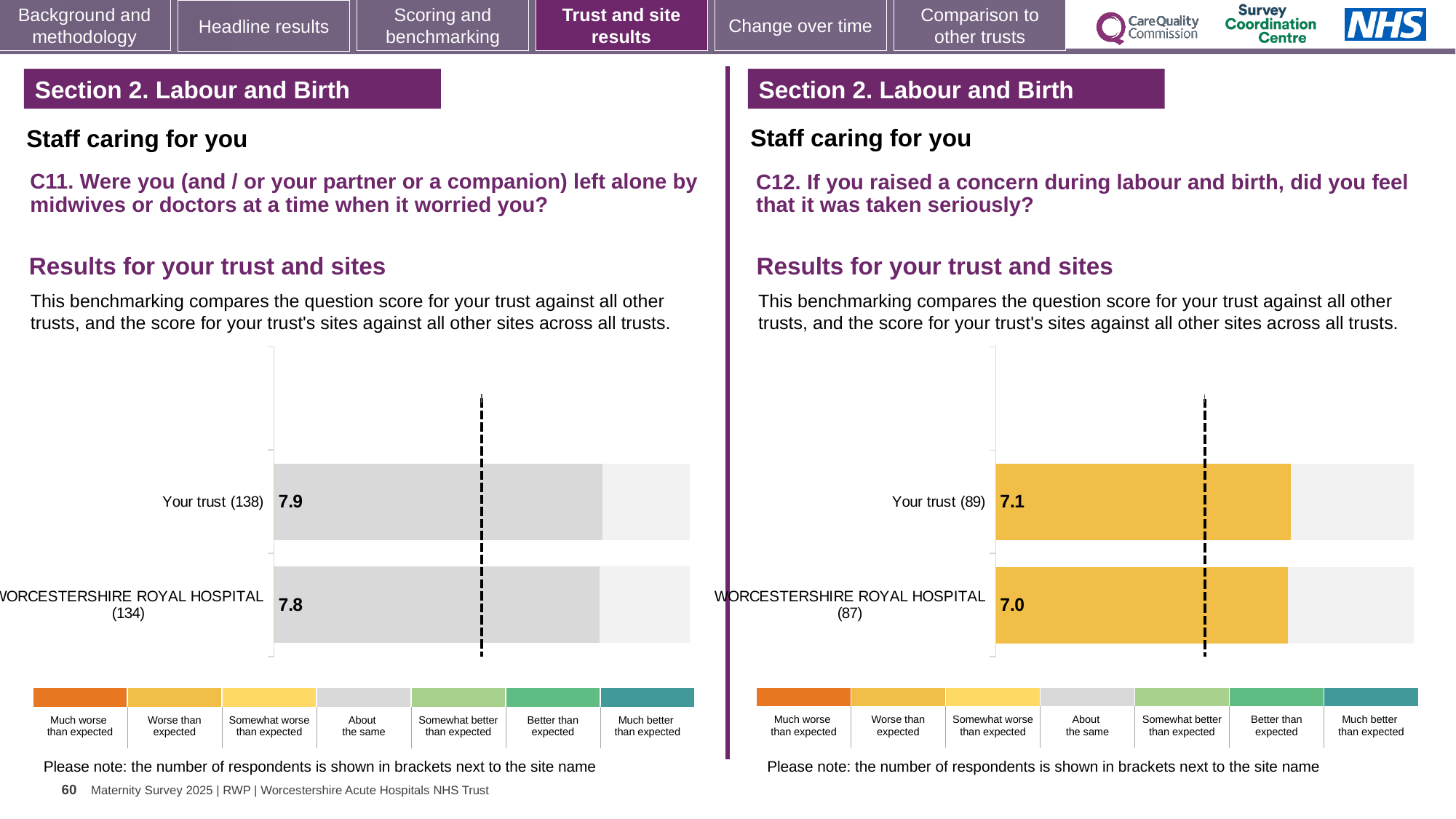
In the C12 chart on the right, which benchmarking category does the yellow colour of the bars correspond to in the key? Worse than expected In the C11 chart on the left, which benchmarking category does the grey colour of the bars correspond to in the key? About the same In the C12 chart on the right, what is the difference between the score for Your trust and the score for WORCESTERSHIRE ROYAL HOSPITAL? 0.1 In the C12 chart on the right, which has the higher score: Your trust or WORCESTERSHIRE ROYAL HOSPITAL? Your trust In the C12 chart on the right, what is the score for WORCESTERSHIRE ROYAL HOSPITAL (87)? 7.0 In the C11 chart on the left, which has the lower score: Your trust or WORCESTERSHIRE ROYAL HOSPITAL? WORCESTERSHIRE ROYAL HOSPITAL In the C12 chart on the right, what is the score for Your trust (89)? 7.1 How many bars are plotted in the C11 chart on the left? 2 What kind of chart is used for the C12 results on the right? Bar chart In the C11 chart on the left, what is the score for WORCESTERSHIRE ROYAL HOSPITAL (134)? 7.8 In the C11 chart on the left, what is the score for Your trust (138)? 7.9 In the C11 chart on the left, what is the difference between the score for Your trust and the score for WORCESTERSHIRE ROYAL HOSPITAL? 0.1